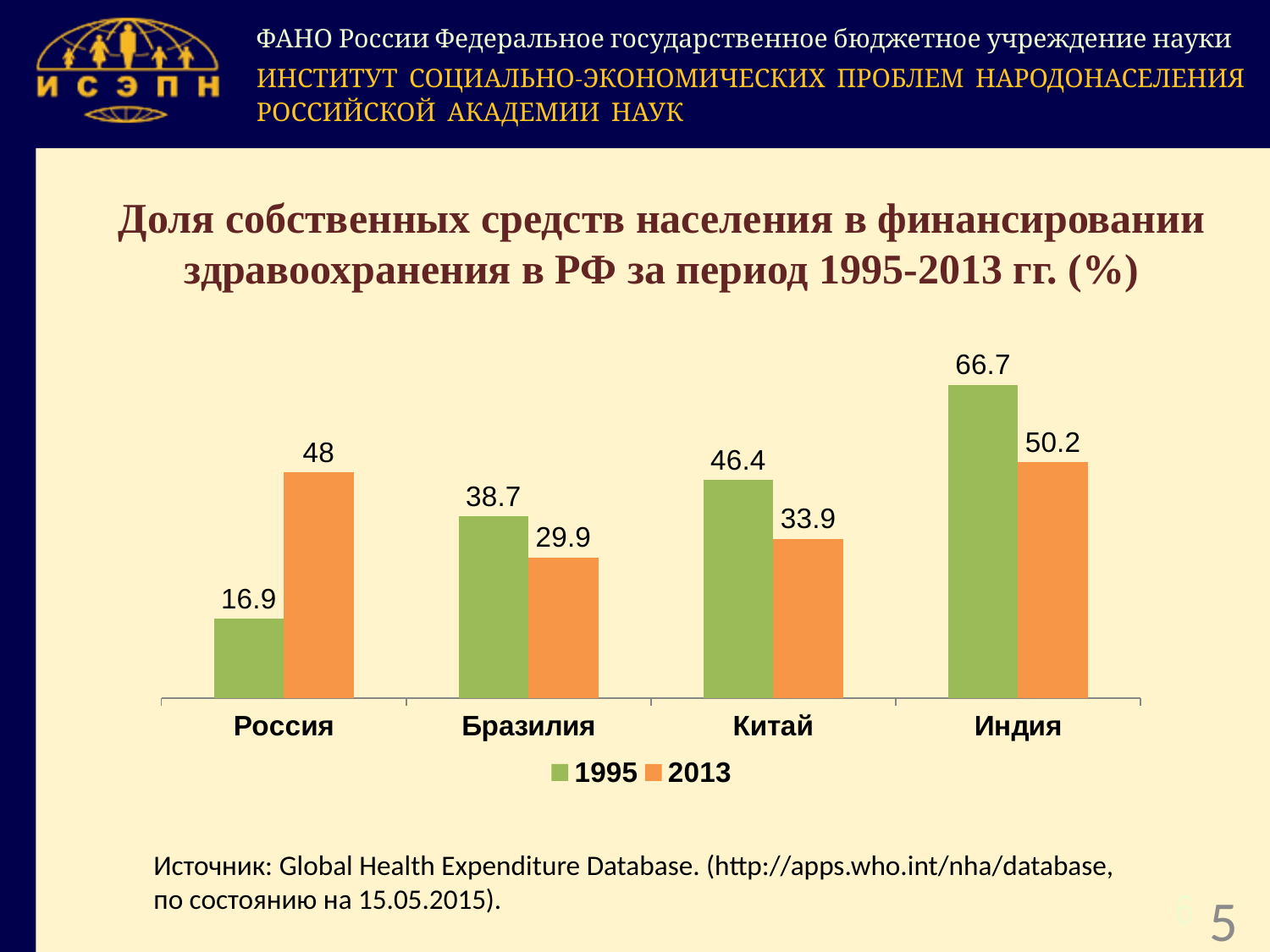
What is the value for Индия in the 2013 series? 50.2 What is the value for Китай in the 1995 series? 46.4 What kind of chart is shown on the slide? Bar chart What is the difference between the 1995 and 2013 values for Индия? 16.5 Which category has the lowest value in the 2013 series? Бразилия What is the difference between the 1995 and 2013 values for Россия? 31.1 Which series is shown in orange in the legend? 2013 How many categories are shown on the x axis? 4 Which category has the highest value in the 1995 series? Индия Which is larger for Бразилия: the 1995 value or the 2013 value? 1995 What is the value for Россия in the 1995 series? 16.9 How many series does the legend list? 2